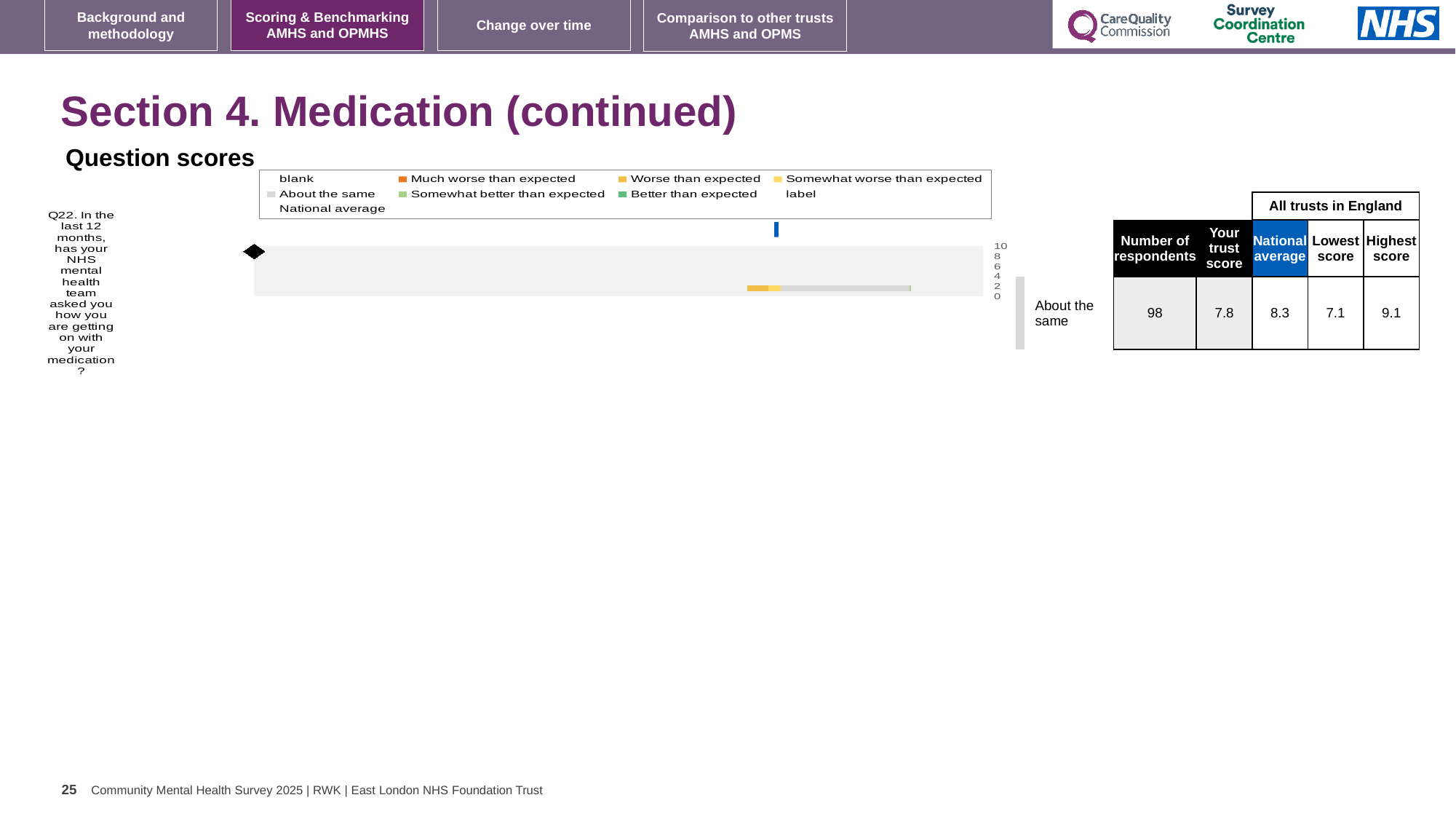
What is the highest score among all trusts in England for Q22? 9.1 What benchmark category is the trust's Q22 score assigned to? About the same What is the highest value shown on the score axis of the question scores chart? 10 How many questions are plotted in the question scores chart? 1 What kind of chart is shown on the slide for the question scores? bar chart What is the difference between the national average and the trust's score for Q22? 0.5 What is the lowest score among all trusts in England for Q22? 7.1 What is the trust's score for Q22 shown on the slide? 7.8 How many respondents answered Q22? 98 What is the national average score for Q22 shown on the slide? 8.3 Which is larger for Q22, the trust's score or the national average? national average Which question number is plotted in the question scores chart? Q22